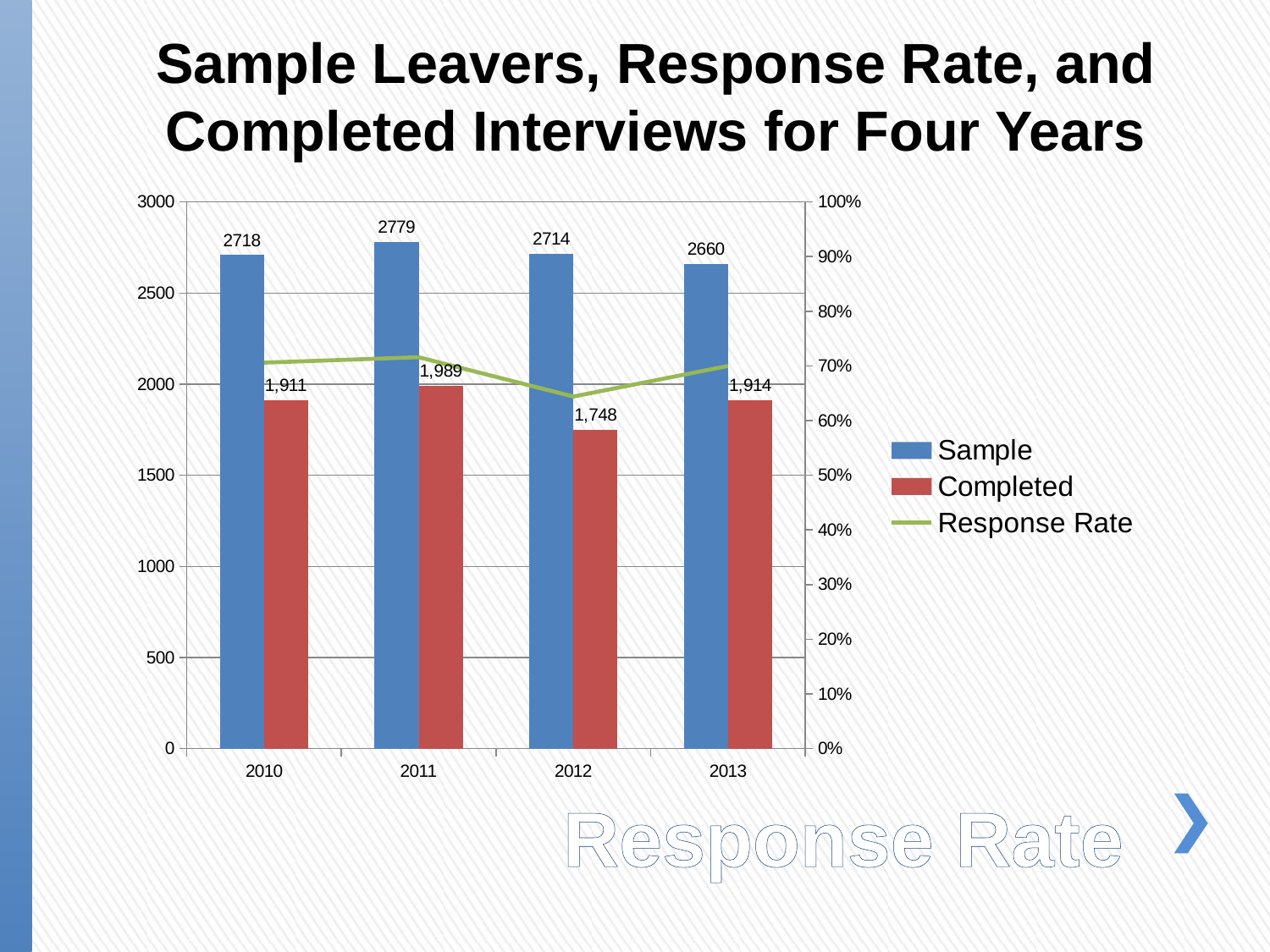
Which series is plotted as a line rather than bars? Response Rate How many years are shown on the x axis? 4 Does the Sample value rise or fall from 2011 to 2013? fall Which is larger, the Completed value for 2011 or the Completed value for 2013? 2011 What is the Sample value for 2011? 2779 What is the Sample value for 2013? 2660 What is the difference between the Sample and Completed values for 2010? 807 Which year has the lowest Completed value? 2012 Which year has the highest Sample value? 2011 Is the Response Rate for 2012 greater or less than 70%? less What is the Completed value for 2012? 1,748 How many series does the legend list? 3